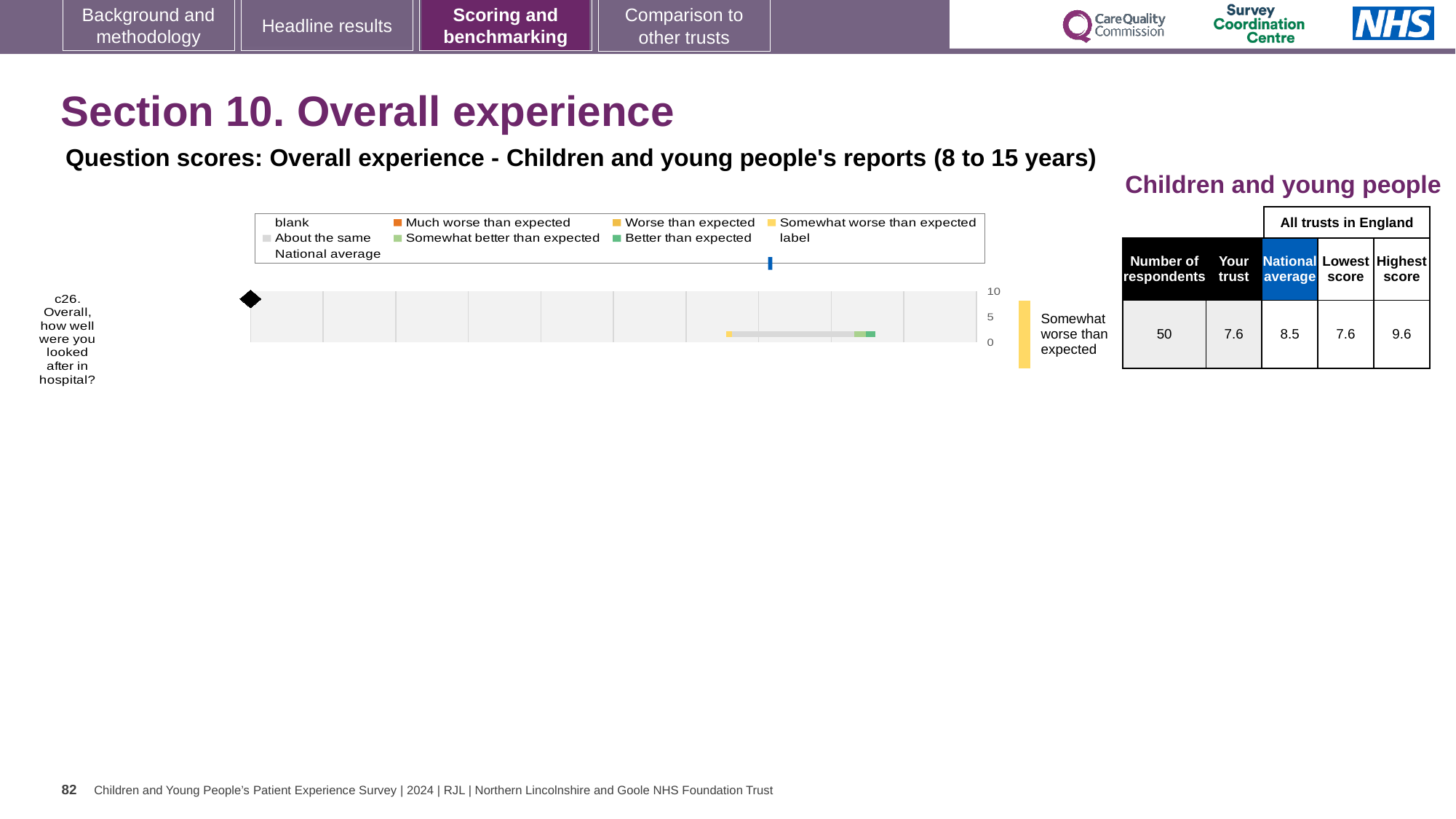
Which question is plotted in the Overall experience chart? c26. Overall, how well were you looked after in hospital? What is the trust's score for question c26? 7.6 How many survey questions are plotted in the Overall experience chart? 1 What is the lowest score among all trusts in England for question c26? 7.6 How many respondents answered question c26? 50 What is the difference between the national average and the trust's score for question c26? 0.9 What rating category is shown beside the bar for question c26? Somewhat worse than expected What kind of chart is used to show the question scores for Overall experience? bar chart Which is higher for question c26, the trust's score or the national average? National average What is the highest score among all trusts in England for question c26? 9.6 What is the national average score for question c26? 8.5